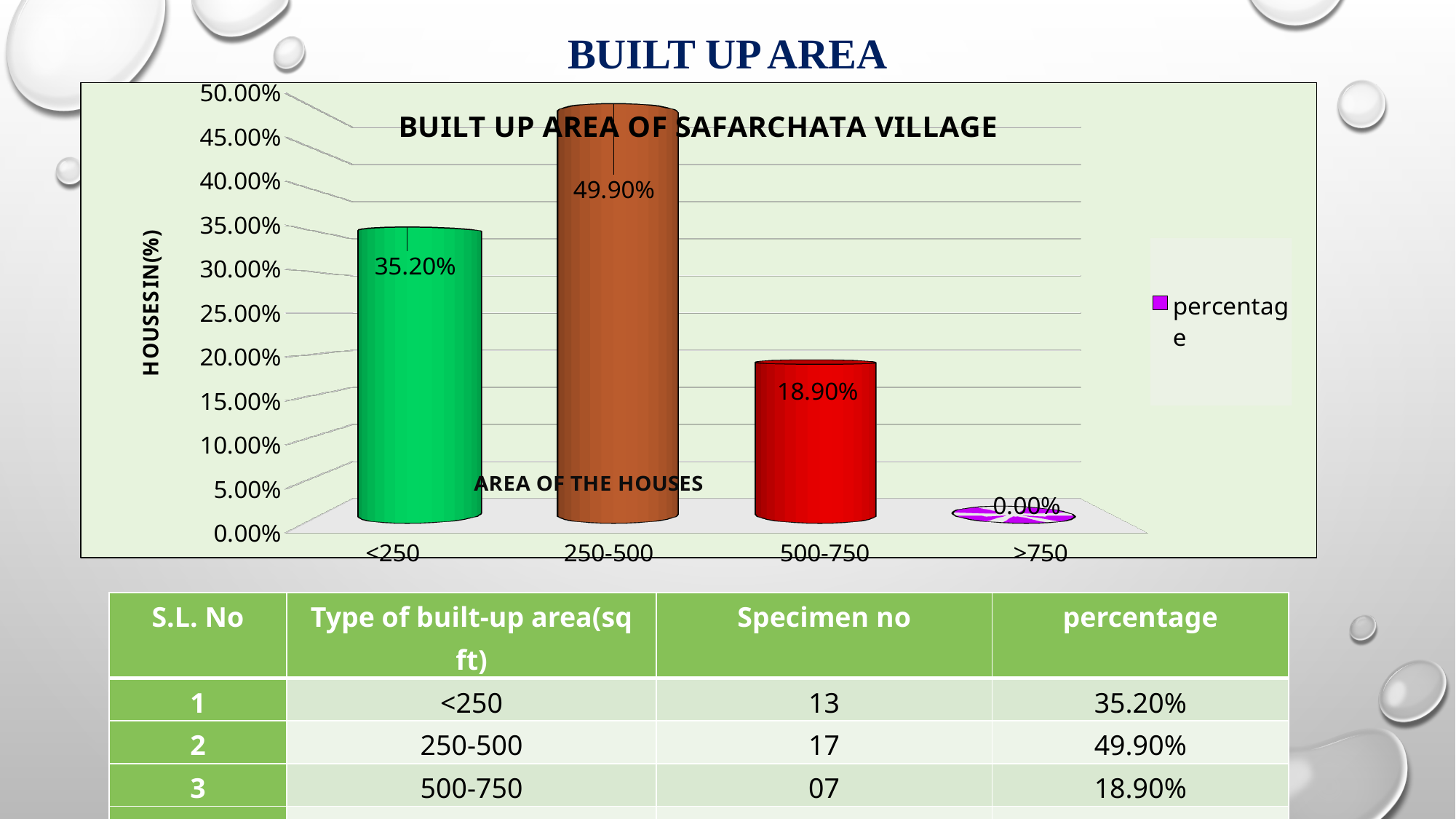
What kind of chart is shown? bar chart How many series does the legend list? 1 What is the value for the 250-500 category? 49.90% Which category has the lowest value? >750 How many categories are shown on the x axis? 4 What is the title of the chart? BUILT UP AREA OF SAFARCHATA VILLAGE Which is larger, the value for <250 or the value for 500-750? <250 What is the value for the <250 category? 35.20% What is the difference between the values for 250-500 and <250? 14.70% What is the value for the 500-750 category? 18.90% Which category has the highest value? 250-500 What is the value for the >750 category? 0.00%